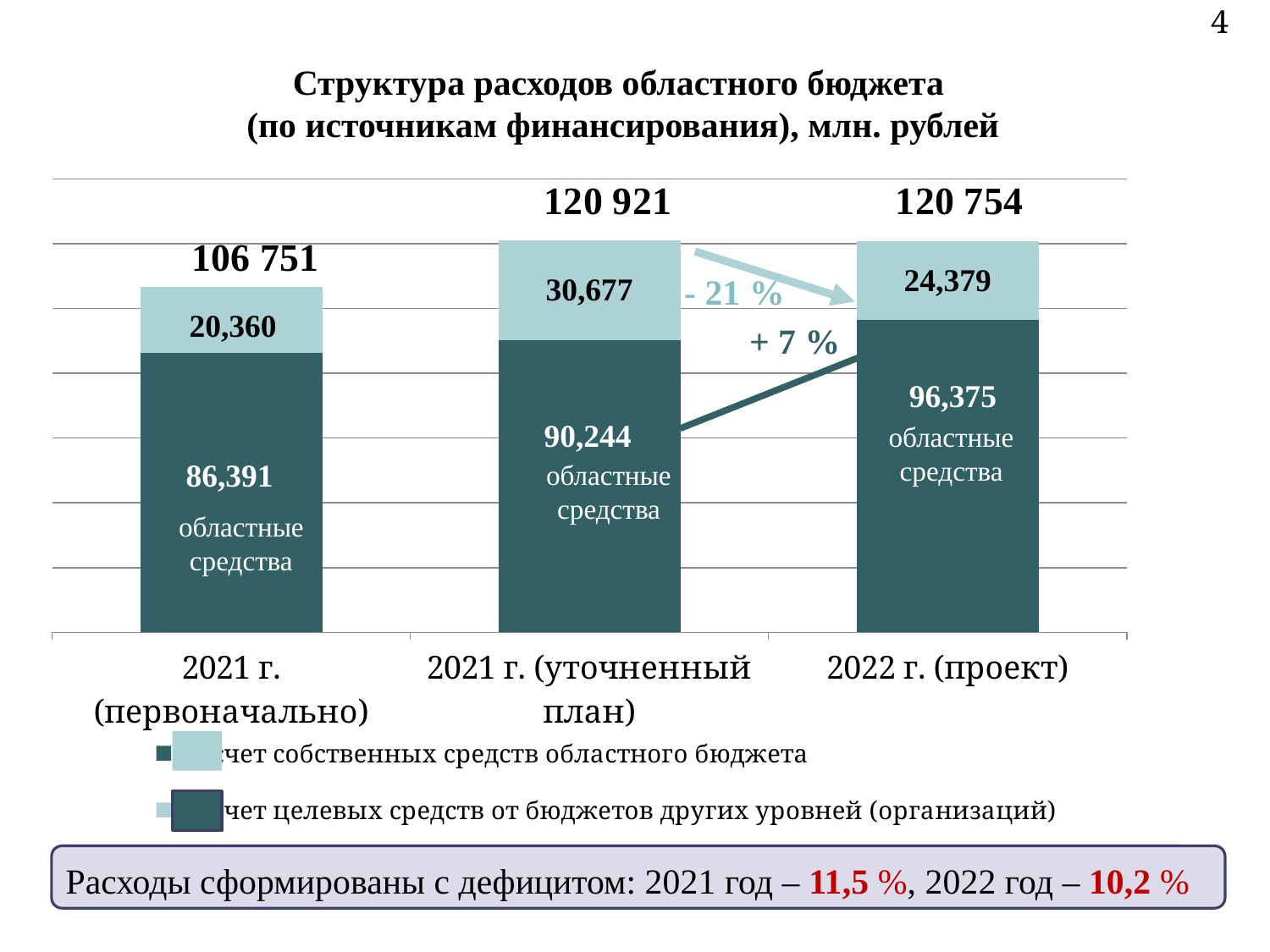
How many categories (bars) are shown on the x axis? 3 What is the value of the "областные средства" segment for "2021 г. (уточненный план)"? 90,244 What is the total value of the bar for "2022 г. (проект)"? 120 754 Which is larger: the upper (light) segment for "2021 г. (уточненный план)" or for "2022 г. (проект)"? 2021 г. (уточненный план) How many series does the legend list? 2 What percentage change is shown by the arrow between the upper segments of "2021 г. (уточненный план)" and "2022 г. (проект)"? - 21 % What is the difference between the "областные средства" values for "2022 г. (проект)" and "2021 г. (первоначально)"? 9,984 Which category has the highest total value? 2021 г. (уточненный план) What kind of chart is shown on the slide? stacked bar chart What is the total value of the bar for "2021 г. (первоначально)"? 106 751 What is the value of the upper (light) segment for "2022 г. (проект)"? 24,379 Which category has the smallest "областные средства" segment? 2021 г. (первоначально)